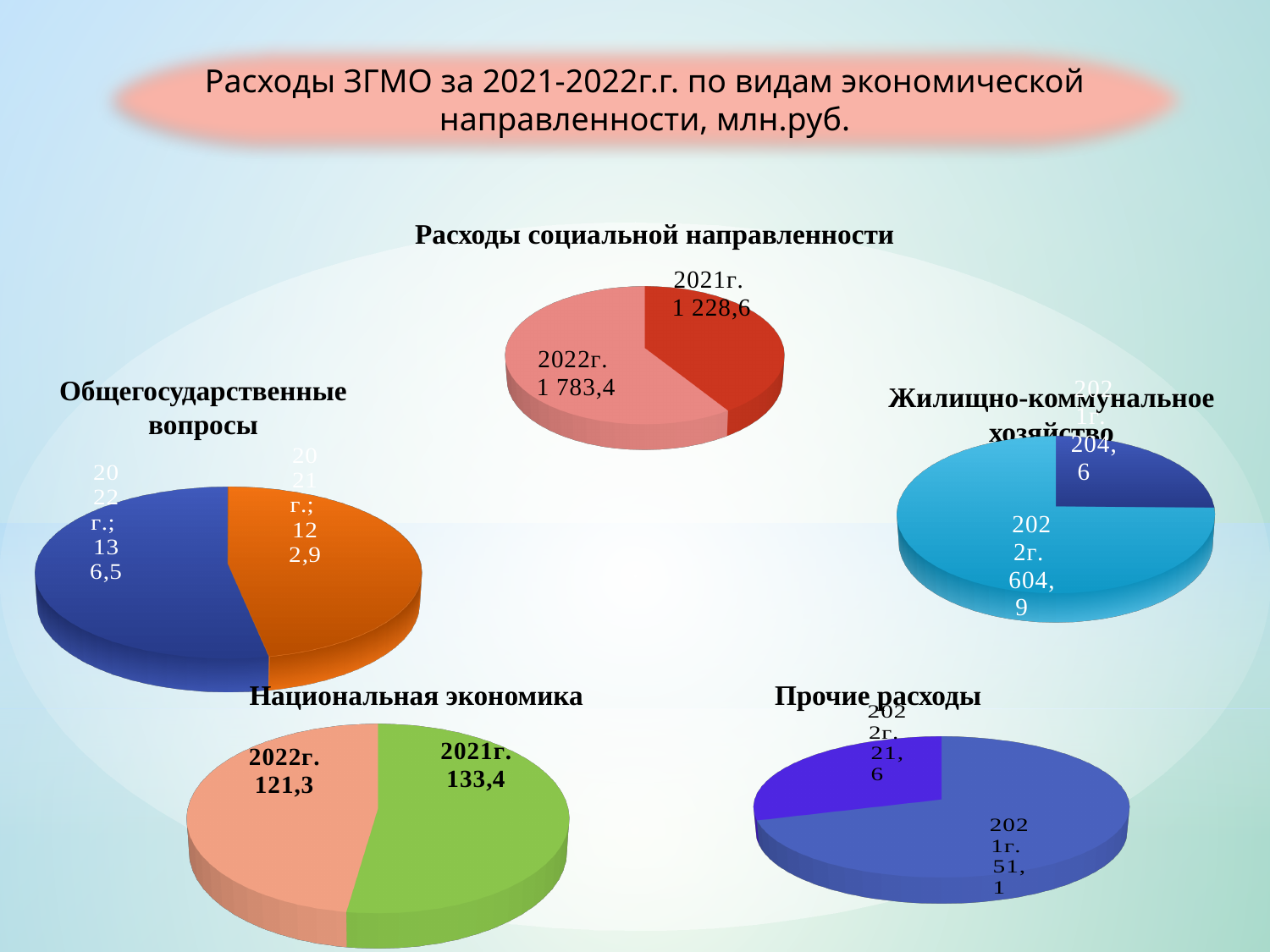
In the chart titled "Расходы социальной направленности", what is the value for 2022г.? 1 783,4 In the chart titled "Прочие расходы", which year has the smaller value? 2022г. How many pie charts are shown on the slide? 5 In the chart titled "Национальная экономика", what is the value for 2021г.? 133,4 In the chart titled "Расходы социальной направленности", what is the value for 2021г.? 1 228,6 In the chart titled "Жилищно-коммунальное хозяйство", what is the difference between the 2022г. and 2021г. values? 400,3 In the chart titled "Расходы социальной направленности", what is the difference between the 2022г. and 2021г. values? 554,8 What kind of chart is used for "Национальная экономика"? Pie chart In the chart titled "Жилищно-коммунальное хозяйство", which year has the larger value, 2021г. or 2022г.? 2022г. In the chart titled "Национальная экономика", what is the difference between the 2021г. and 2022г. values? 12,1 In the chart titled "Жилищно-коммунальное хозяйство", what is the value for 2022г.? 604,9 In the chart titled "Прочие расходы", what is the value for 2021г.? 51,1